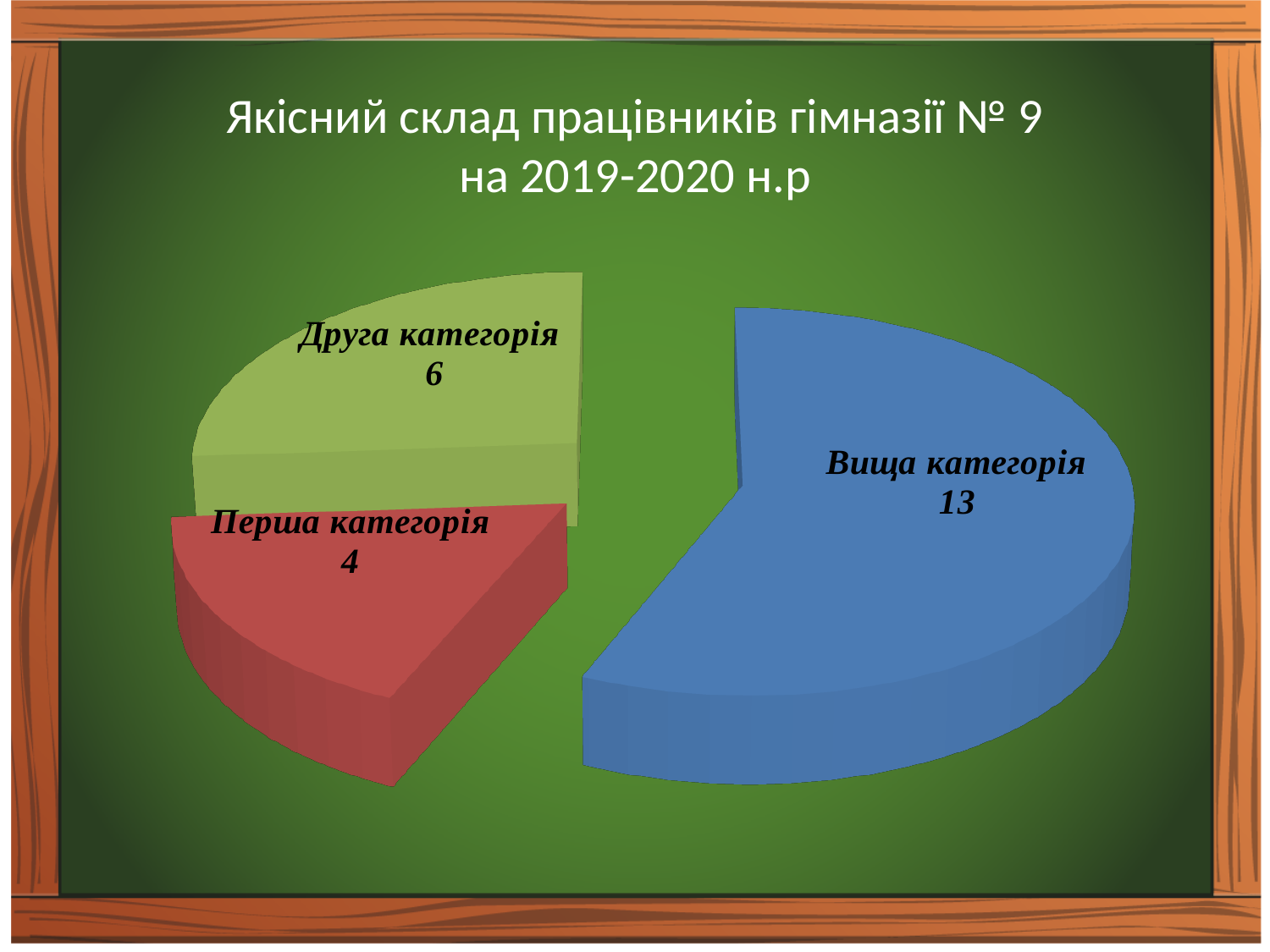
Which category has the smallest slice? Перша категорія What is the value for Перша категорія? 4 How many categories does the pie chart show? 3 What is the difference between the values for Друга категорія and Перша категорія? 2 What type of chart is shown on the slide? Pie chart What is the title of the chart slide? Якісний склад працівників гімназії № 9 на 2019-2020 н.р What is the total of all slices in the pie chart? 23 What is the value for Вища категорія? 13 Which is larger, Друга категорія or Перша категорія? Друга категорія Which category has the largest slice? Вища категорія What is the value for Друга категорія? 6 What is the difference between the values for Вища категорія and Друга категорія? 7